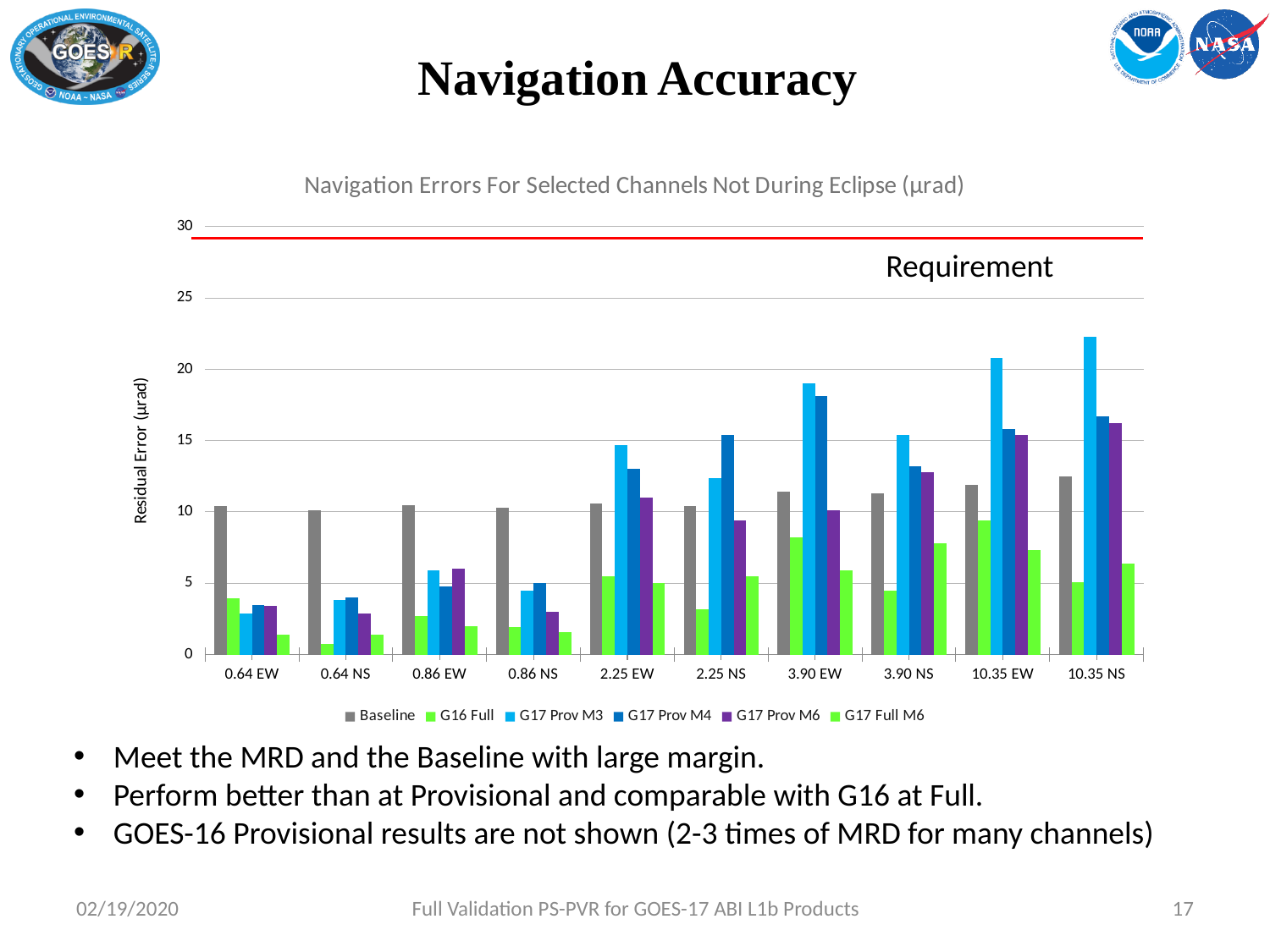
At 0.64 EW, which is larger: the Baseline value or the G17 Prov M3 value? Baseline Is the G17 Prov M3 value for 3.90 EW greater or less than 15? greater What is the title of the chart? Navigation Errors For Selected Channels Not During Eclipse (μrad) For which category is the G16 Full value lowest? 0.64 NS How many channel categories are shown along the x axis? 10 Is the G16 Full value for 0.64 NS greater or less than 5? less How many series does the chart legend list? 6 For which category is the G17 Prov M3 value highest? 10.35 NS Is the G17 Prov M3 value for 10.35 NS greater or less than 20? greater What kind of chart is shown on the slide? bar chart What does the red horizontal line at the top of the chart represent? Requirement